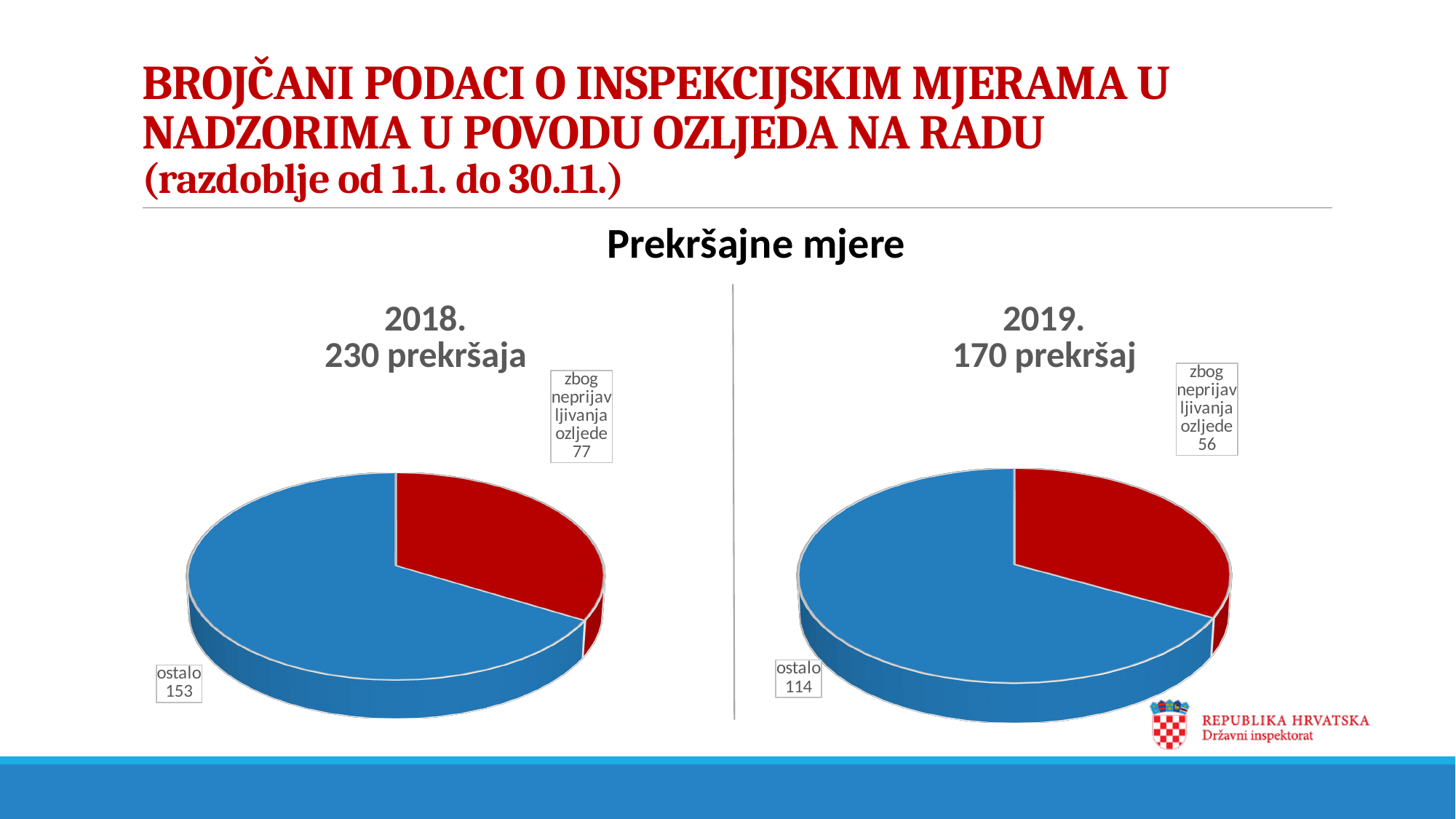
What type of chart is used for the 2019 data? Pie chart In the 2018 pie chart, what is the difference between 'ostalo' and 'zbog neprijavljivanja ozljede'? 76 In the 2019 pie chart, what is the value for 'zbog neprijavljivanja ozljede'? 56 In the 2018 pie chart, what is the value for 'zbog neprijavljivanja ozljede'? 77 What is the total of the two slices in the 2019 pie chart? 170 In the 2018 pie chart, which slice is the largest? ostalo In the 2018 pie chart, what is the value for 'ostalo'? 153 In the 2019 pie chart, which slice is the smallest? zbog neprijavljivanja ozljede How many slices does the 2018 pie chart have? 2 What is the title shown above the two pie charts? Prekršajne mjere Which is larger: 'zbog neprijavljivanja ozljede' in the 2018 chart or in the 2019 chart? 2018 In the 2019 pie chart, what is the value for 'ostalo'? 114